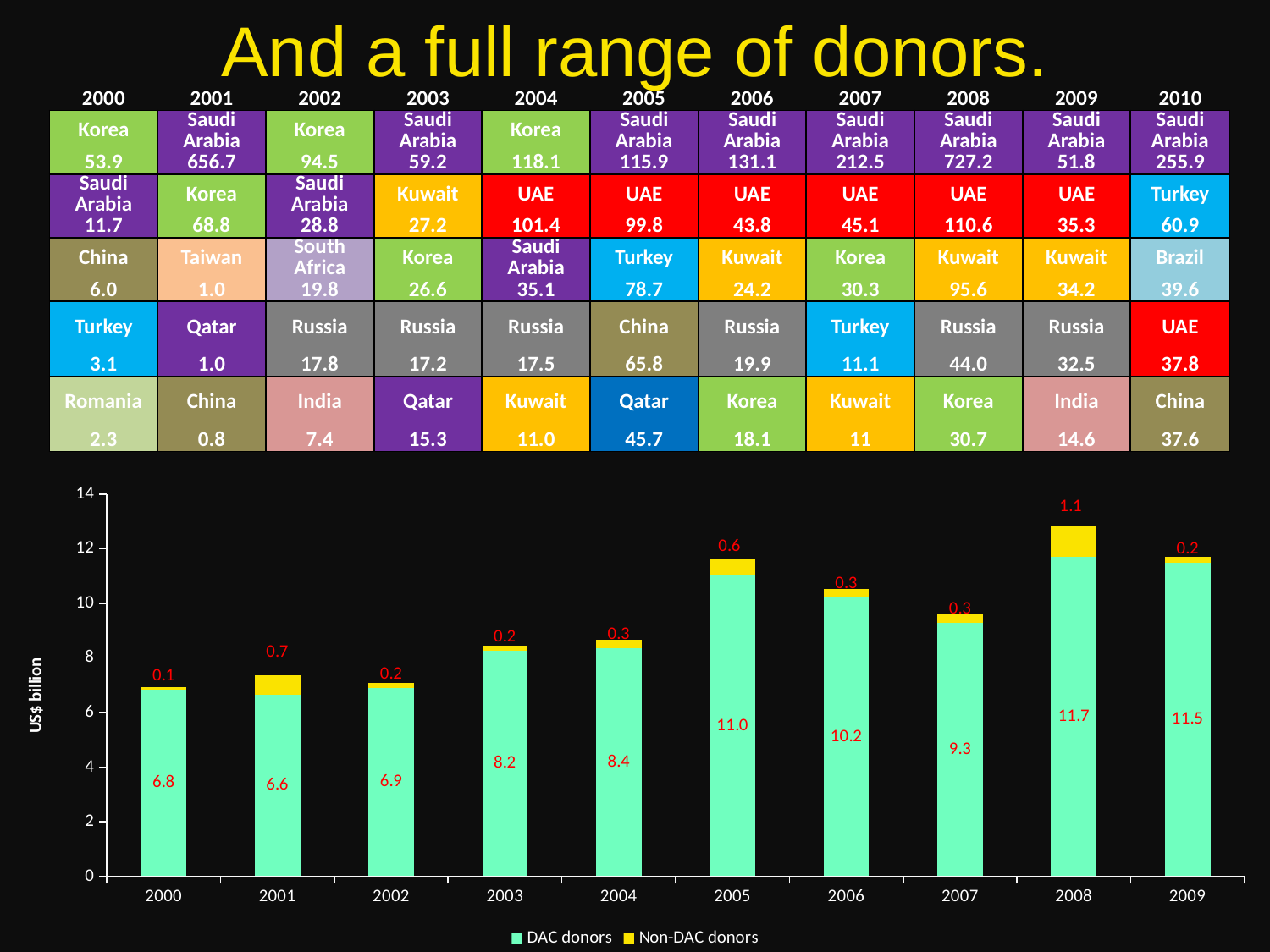
How many series does the chart legend list? 2 What is the label on the vertical axis of the chart? US$ billion What is the value for DAC donors in 2005? 11.0 What type of chart is shown at the bottom of the slide? stacked bar chart What is the difference between the DAC donors values for 2009 and 2000? 4.7 Which year has the lowest value for Non-DAC donors? 2000 Which year has the highest value for DAC donors? 2008 What is the value for DAC donors in 2001? 6.6 What is the total of the stacked bar for 2008? 12.8 What is the value for Non-DAC donors in 2008? 1.1 Which is larger, the DAC donors value for 2006 or for 2007? 2006 How many years are shown on the x axis of the chart? 10